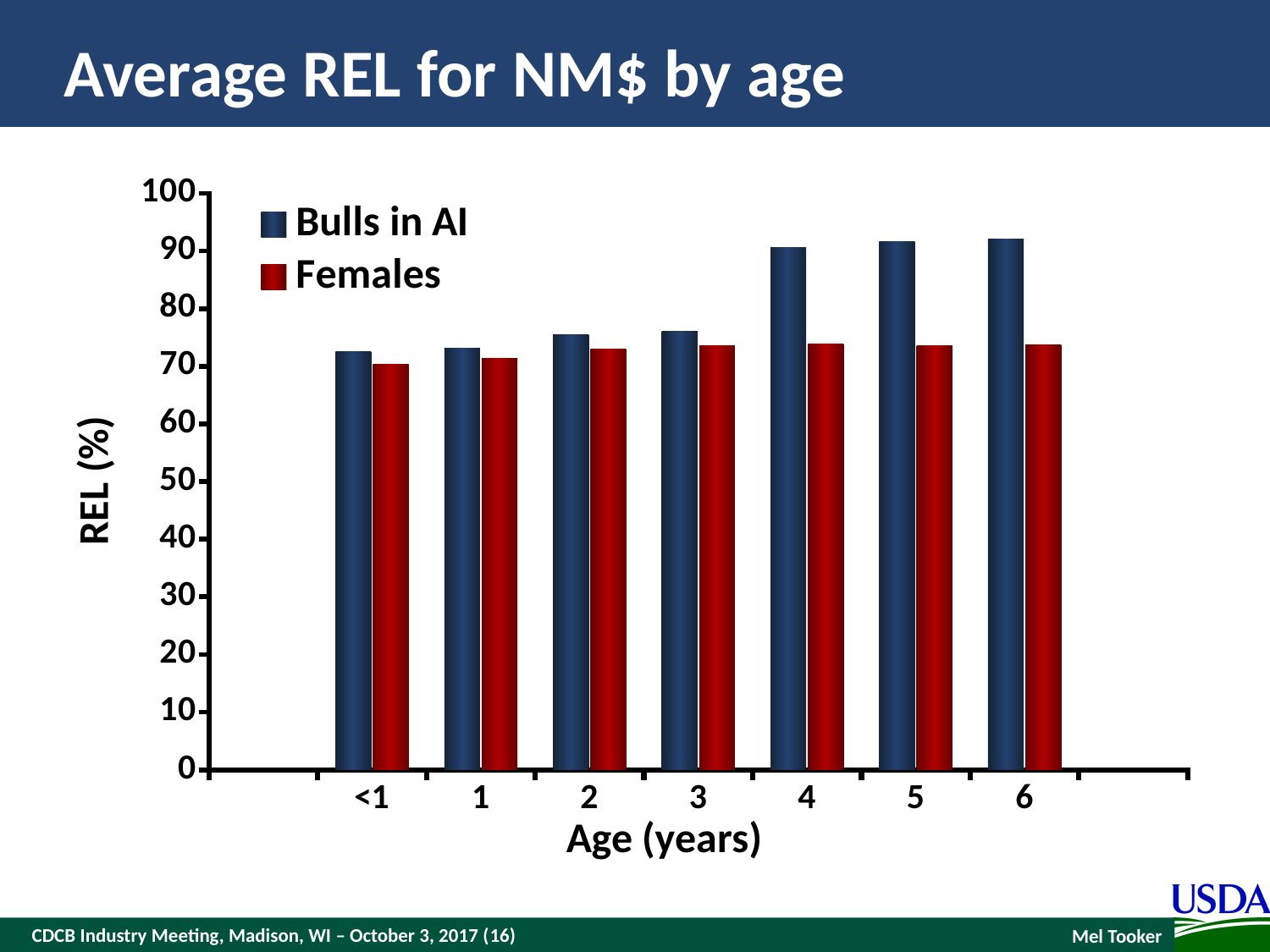
How many age categories are shown on the x axis? 7 What kind of chart is shown on the slide? bar chart Is the value for Bulls in AI at age 6 greater or less than 90? greater What are the two series named in the legend? Bulls in AI and Females Is the value for Females at age 6 greater or less than 70? greater Is the value for Females at age 4 greater or less than 80? less Which is larger for Bulls in AI: the value at age 3 or the value at age 4? age 4 How many series does the legend list? 2 Which is larger at age 4: the value for Bulls in AI or the value for Females? Bulls in AI Do the values for Bulls in AI generally rise or fall as age increases? rise What is the label of the y axis? REL (%)